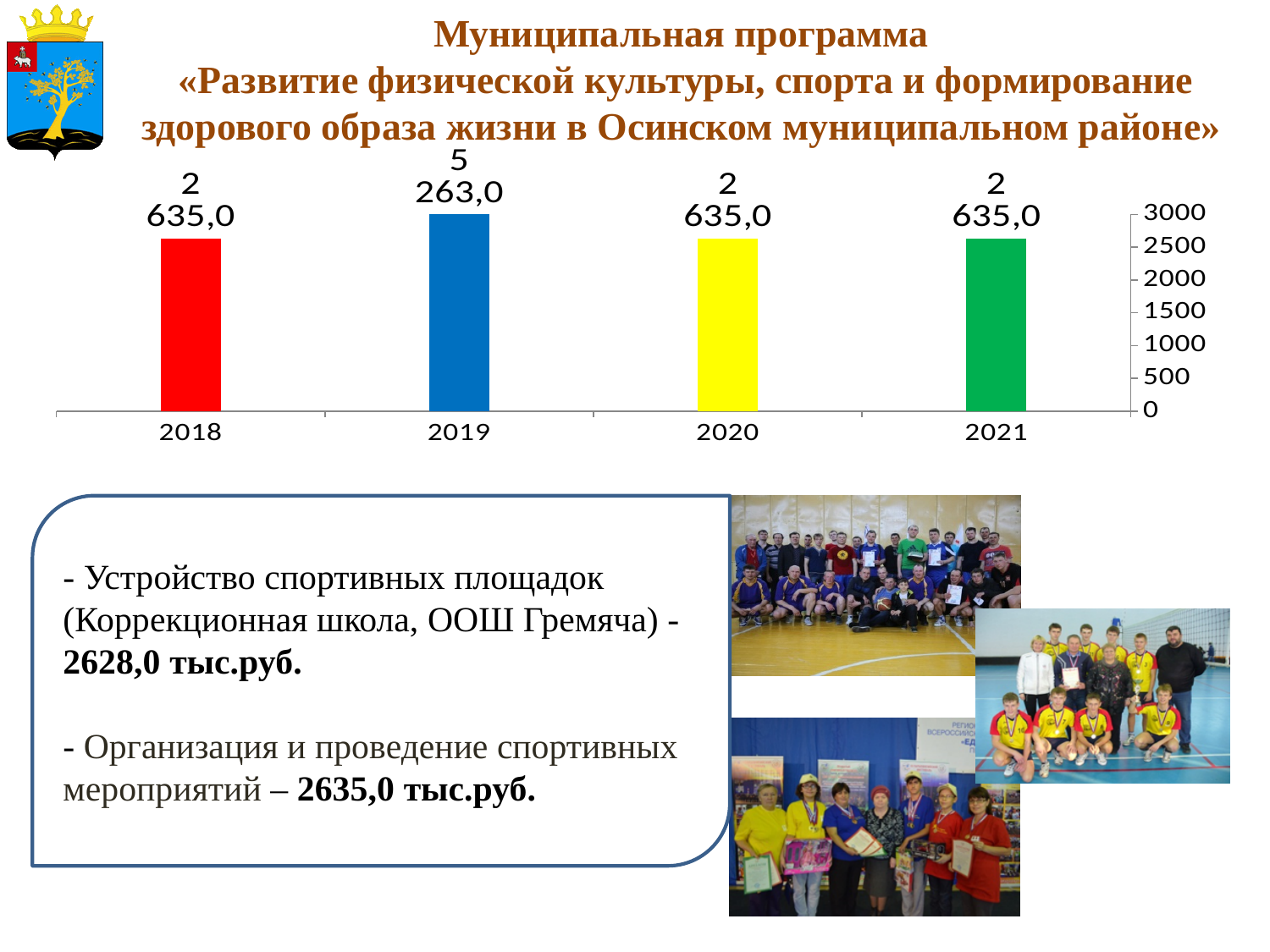
What kind of chart is shown on the slide? bar chart How many years are shown on the x axis? 4 Is the value for 2021 greater or less than 3000? less Which is larger, the value for 2019 or the value for 2020? 2019 What is the value for 2018? 2 635,0 Which year has the highest value? 2019 What is the value for 2019? 5 263,0 Is the value for 2020 greater or less than 2000? greater What is the highest value shown on the vertical axis? 3000 What is the value for 2021? 2 635,0 What colour is the bar for 2019? blue What is the difference between the values for 2019 and 2018? 2 628,0